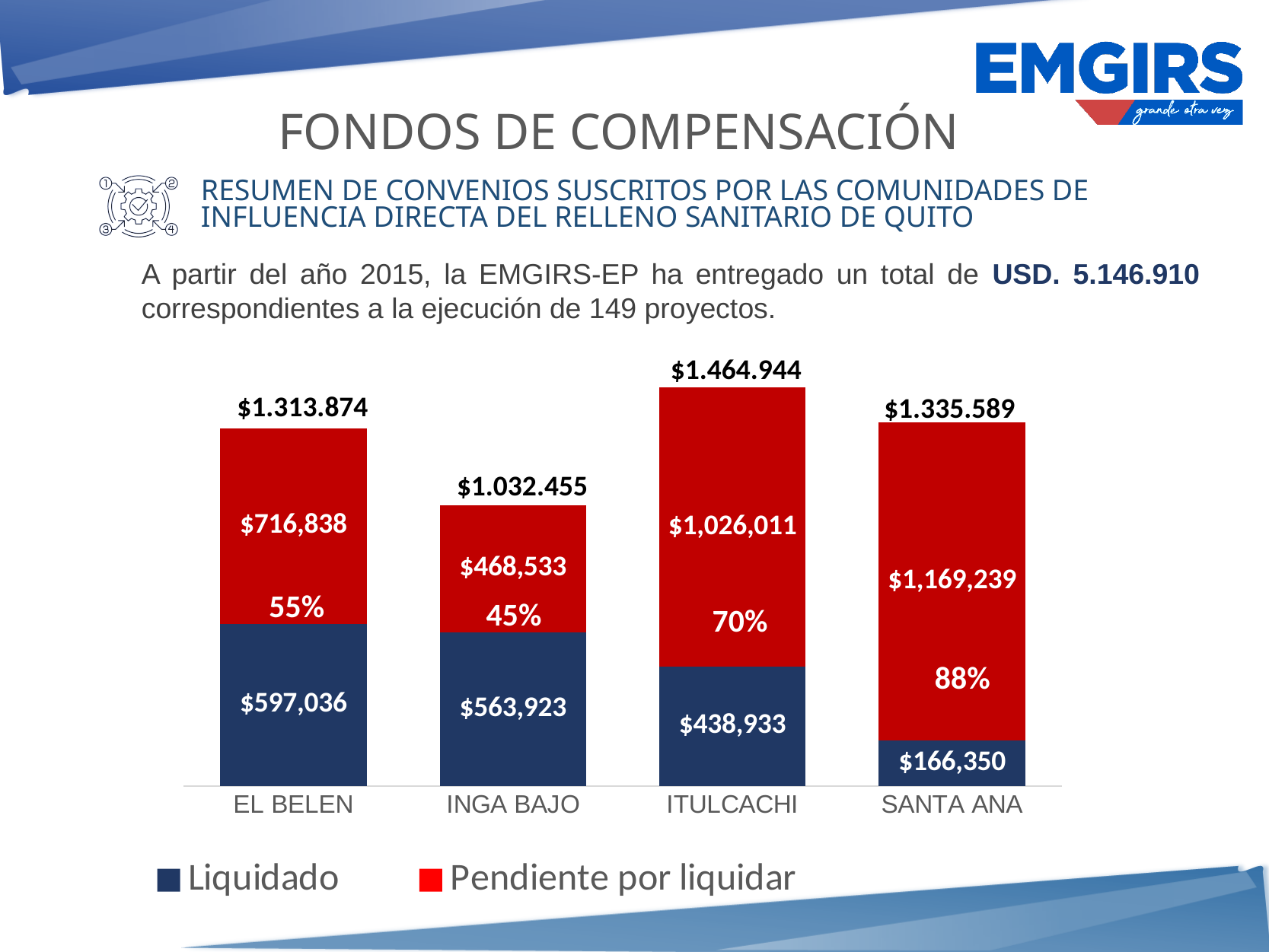
What is the difference between the Pendiente por liquidar and Liquidado values for EL BELEN? $119,802 Which category has the highest total shown above its bar? ITULCACHI What is the total shown above the INGA BAJO bar? $1.032.455 Which is larger, the Liquidado value for EL BELEN or for INGA BAJO? EL BELEN What kind of chart is shown on the slide? Stacked bar chart What is the Liquidado value for EL BELEN? $597,036 What percentage is shown on the ITULCACHI bar? 70% What is the Pendiente por liquidar value for SANTA ANA? $1,169,239 How many series does the legend list? 2 How many categories are shown on the x axis? 4 What colour represents the Liquidado series in the legend? Dark blue Which category has the lowest Liquidado value? SANTA ANA